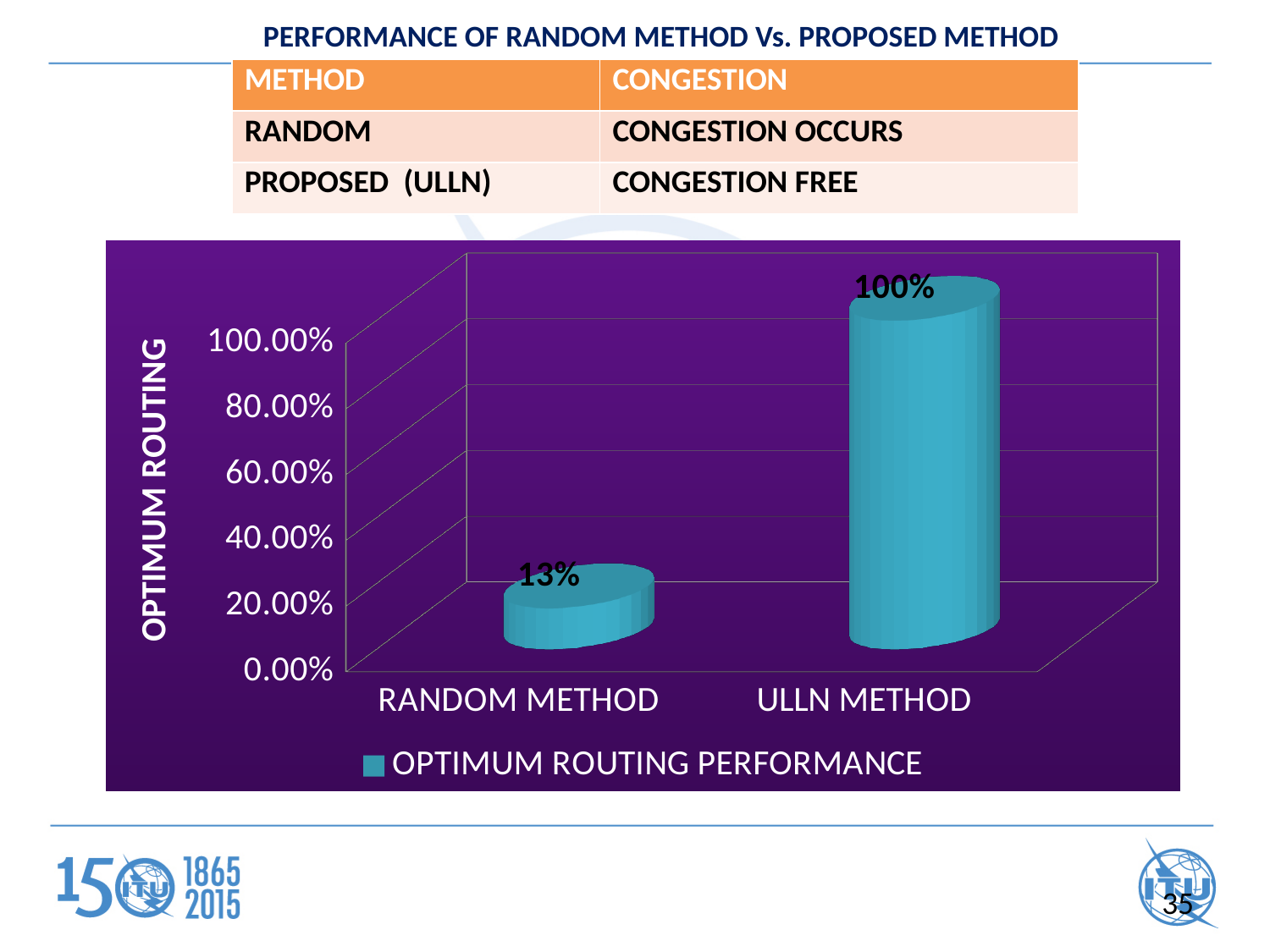
Which method has the lowest optimum routing performance? RANDOM METHOD What is the label of the vertical axis of the chart? OPTIMUM ROUTING Which has a larger optimum routing performance value, the RANDOM METHOD or the ULLN METHOD? ULLN METHOD What kind of chart is shown on the slide? Bar chart What is the optimum routing performance value for the ULLN METHOD? 100% What is the optimum routing performance value for the RANDOM METHOD? 13% Is the value for the RANDOM METHOD greater or less than 20.00%? less What is the difference in optimum routing performance between the ULLN METHOD and the RANDOM METHOD? 87% Is the value for the ULLN METHOD greater or less than 80.00%? greater How many methods are plotted on the chart? 2 How many series does the chart legend list? 1 Which method has the highest optimum routing performance? ULLN METHOD